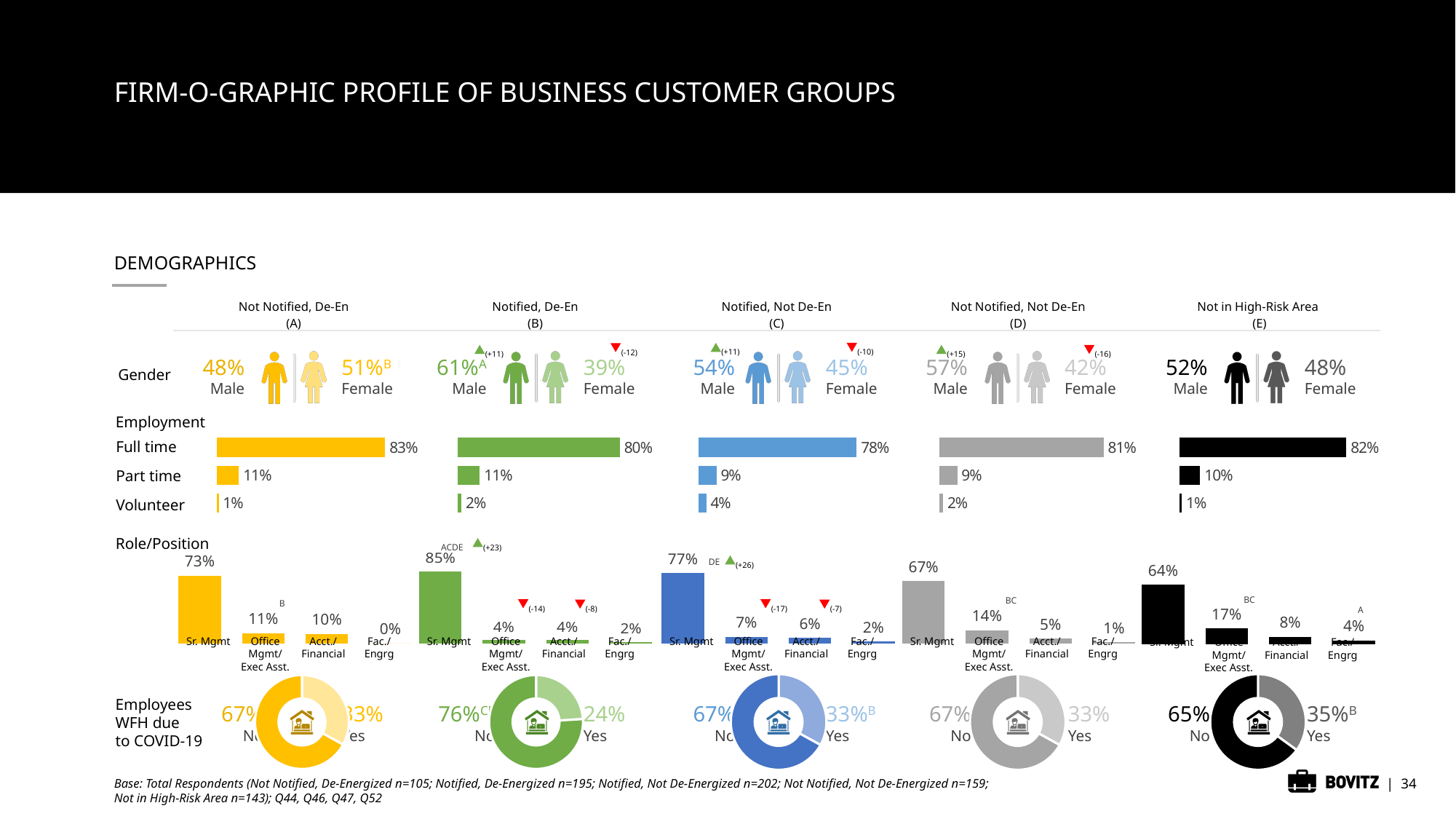
In the Role/Position bar chart for the Not in High-Risk Area (E) group, which role has the lowest percentage? Fac./Engrg In the Employment bar chart for the Notified, De-En (B) group, what percentage is Full time? 80% In the Employees WFH due to COVID-19 donut chart for the Notified, De-En (B) group, what percentage answered Yes? 24% In the Gender section for the Notified, Not De-En (C) group, what percentage is Female? 45% Across the five groups' Employment bar charts, which group has the highest Full time percentage? Not Notified, De-En (A) In the Employees WFH due to COVID-19 donut chart for the Not in High-Risk Area (E) group, what share of the donut is No? 65% In the Role/Position bar chart for the Not Notified, Not De-En (D) group, what is the difference between Sr. Mgmt and Office Mgmt/Exec Asst.? 53% In the Employment bar chart for the Notified, Not De-En (C) group, what percentage is Volunteer? 4% In the Role/Position bar chart for the Notified, De-En (B) group, what percentage is Sr. Mgmt? 85% What type of chart is used for the Employees WFH due to COVID-19 section? Donut (pie) chart How many role categories are shown in each Role/Position bar chart? 4 In the Role/Position bar chart for the Not Notified, De-En (A) group, which is larger: Office Mgmt/Exec Asst. or Acct./Financial? Office Mgmt/Exec Asst.